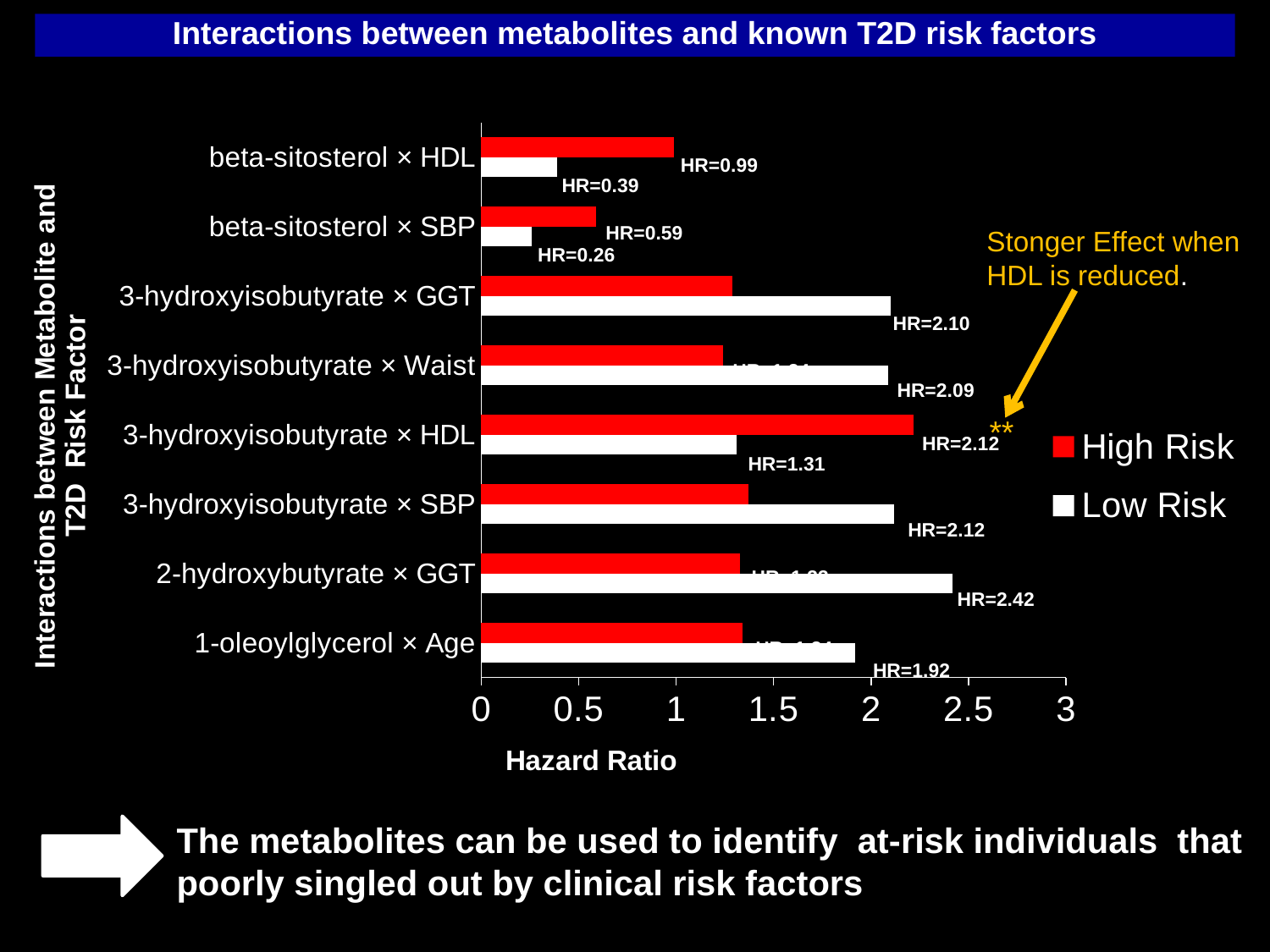
How many series does the legend list? 2 For 3-hydroxyisobutyrate × HDL, which is larger, the High Risk or the Low Risk hazard ratio? High Risk Which interaction has the lowest Low Risk hazard ratio? beta-sitosterol × SBP Is the High Risk hazard ratio for 3-hydroxyisobutyrate × GGT greater or less than 1.5? less Which interaction has the highest High Risk hazard ratio? 3-hydroxyisobutyrate × HDL What is the difference between the High Risk and Low Risk hazard ratios for beta-sitosterol × HDL? 0.60 What kind of chart is shown on the slide? bar chart How many metabolite × risk factor interactions are plotted on the chart? 8 Which interaction has the highest Low Risk hazard ratio? 2-hydroxybutyrate × GGT What is the High Risk hazard ratio for beta-sitosterol × HDL? HR=0.99 What is the Low Risk hazard ratio for beta-sitosterol × SBP? HR=0.26 What is the Low Risk hazard ratio for 2-hydroxybutyrate × GGT? HR=2.42